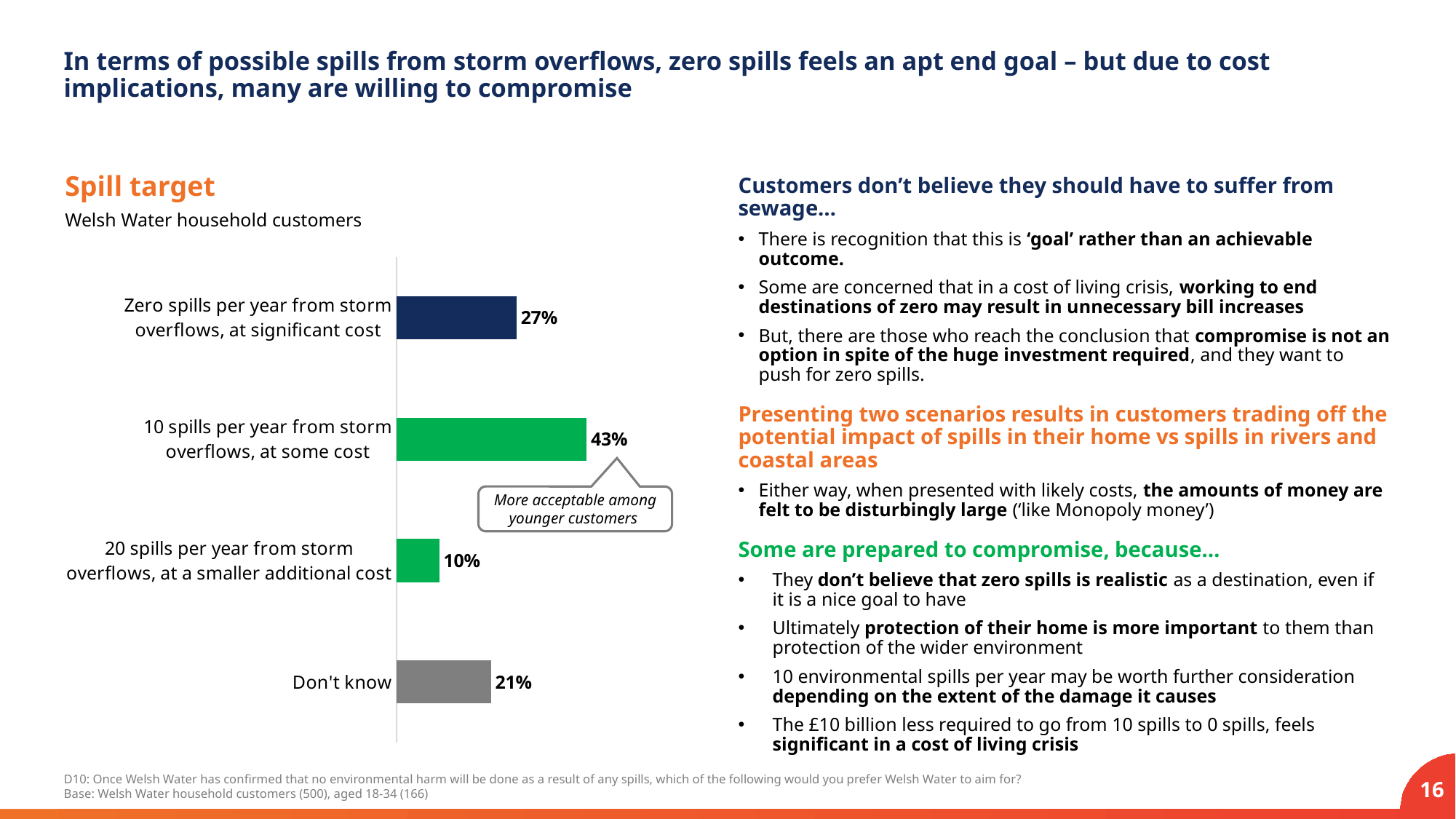
What percentage of customers chose '20 spills per year from storm overflows, at a smaller additional cost'? 10% Which category has the lowest value in the Spill target chart? 20 spills per year from storm overflows, at a smaller additional cost What is the difference between the 'Don't know' share and the '20 spills per year' share? 11 percentage points Which is larger: the share choosing 'Zero spills per year' or the share answering 'Don't know'? Zero spills per year What percentage of customers answered 'Don't know'? 21% What percentage of Welsh Water household customers chose '10 spills per year from storm overflows, at some cost'? 43% What percentage of customers chose 'Zero spills per year from storm overflows, at significant cost'? 27% According to the callout on the chart, among which group is the '10 spills per year' option more acceptable? Younger customers What type of chart is used to show the Spill target results? Bar chart What is the difference in percentage points between the '10 spills per year' option and the 'Zero spills per year' option? 16 percentage points How many categories are shown in the Spill target chart? 4 Which spill target option received the highest share of customers? 10 spills per year from storm overflows, at some cost